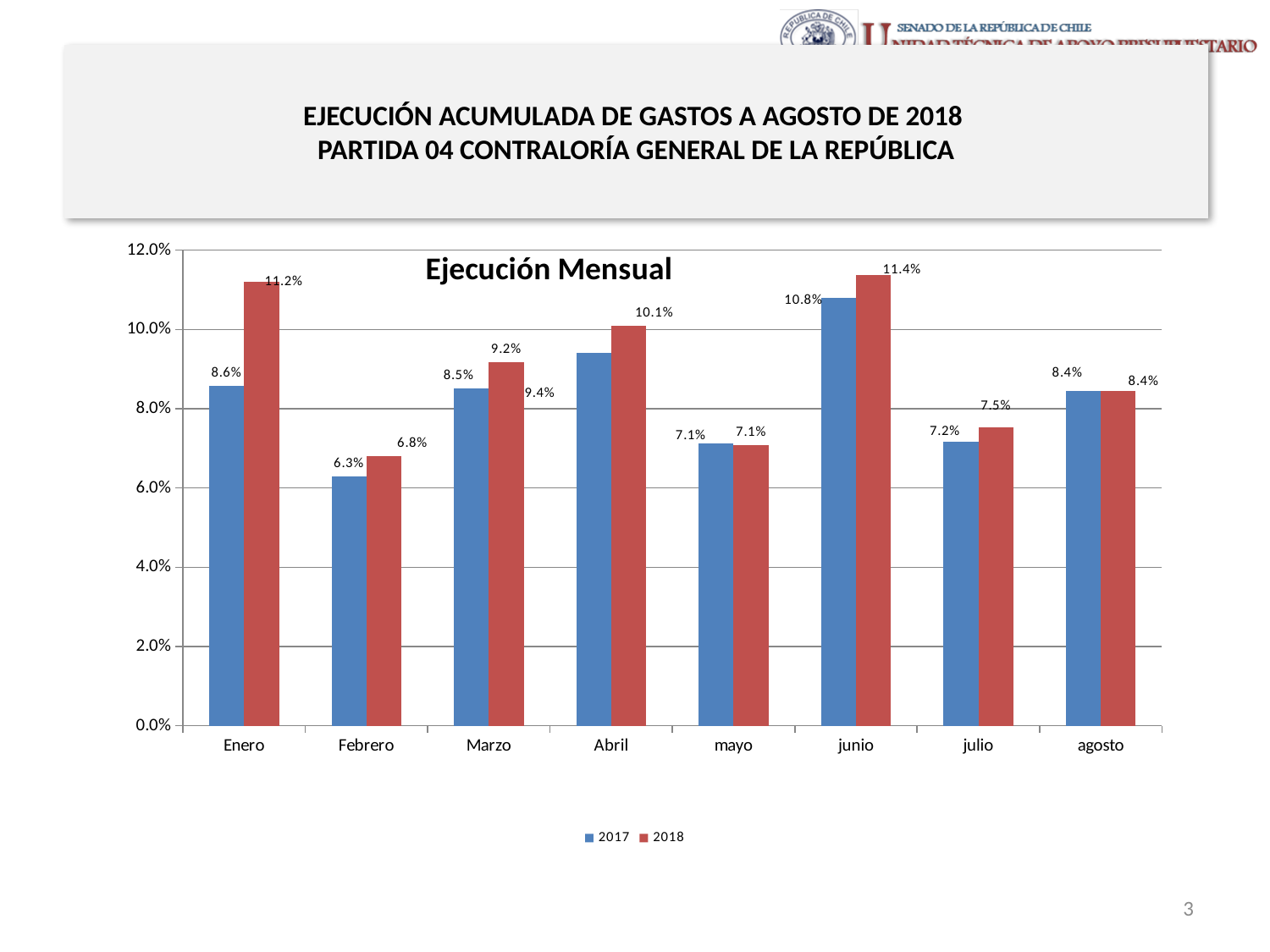
What is the title of the chart? Ejecución Mensual What is the value for 2017 in junio? 10.8% What is the value for 2018 in Enero? 11.2% How many months are shown on the x axis? 8 Which month has the highest value for the 2018 series? junio Is the value for 2017 in Abril greater or less than 8.0%? greater In Marzo, which series has the larger value, 2017 or 2018? 2018 What kind of chart is shown on the slide? bar chart What is the value for 2018 in julio? 7.5% Which month has the lowest value for the 2017 series? Febrero What is the difference between the 2018 and 2017 values in Enero? 2.6 percentage points How many series does the legend list? 2